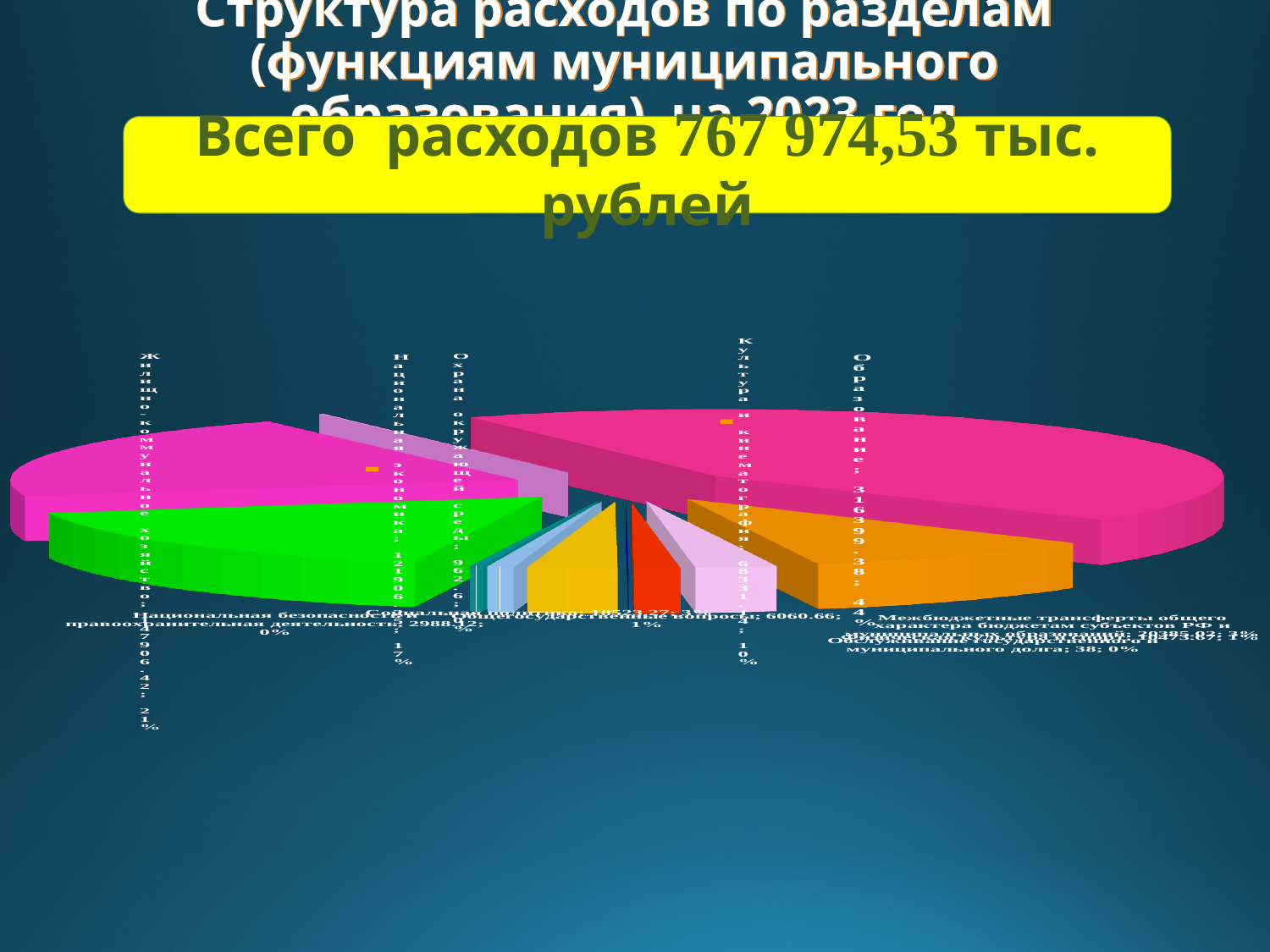
What is the value shown for Обслуживание государственного и муниципального долга? 38 What share of expenditures does Жилищно-коммунальное хозяйство account for? 21% What is the value shown for Национальная безопасность и правоохранительная деятельность? 2988.12 What share of expenditures does Образование account for? 44% Which category has the largest share of expenditures in the pie chart? Образование What total amount of expenditures is stated on the slide? 767 974,53 тыс. рублей What share of expenditures does Национальная экономика account for? 17% Which has a larger share of expenditures, Образование or Жилищно-коммунальное хозяйство? Образование By how many percentage points does the share of Образование exceed the share of Жилищно-коммунальное хозяйство? 23 What is the value shown for Общегосударственные вопросы? 6060.66 What kind of chart is shown on the slide? pie chart